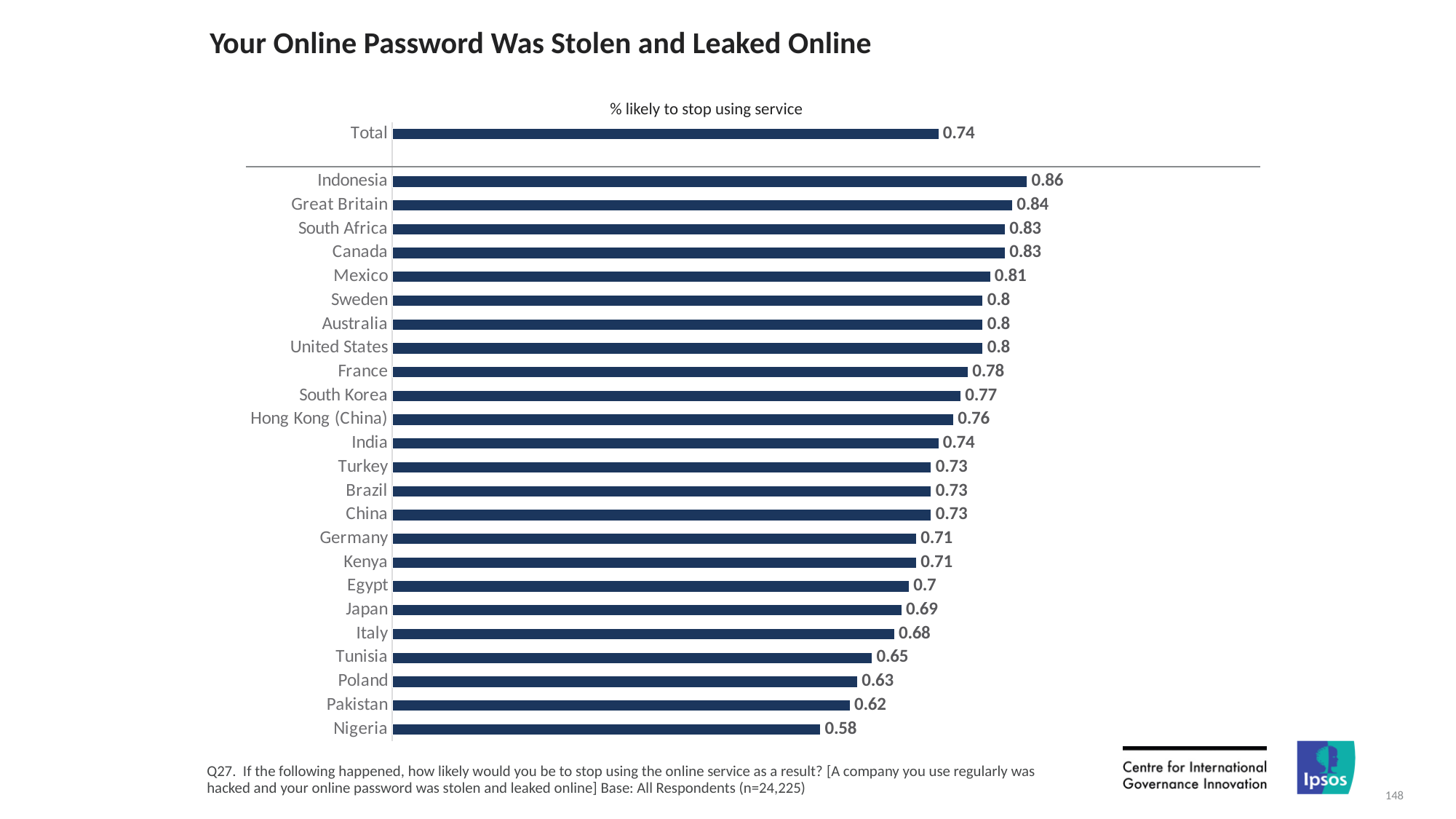
What is the value for Total? 0.74 What is the difference between the values for Indonesia and Nigeria? 0.28 How many countries are listed below the Total bar? 24 What kind of chart is shown on the slide? Bar chart What is the value for Indonesia? 0.86 Which country has the highest value? Indonesia Which has a larger value, Mexico or Poland? Mexico What is the value for Hong Kong (China)? 0.76 What is the value for Nigeria? 0.58 What is the title of the chart? % likely to stop using service Which country has the lowest value? Nigeria What is the difference between the values for Great Britain and Japan? 0.15